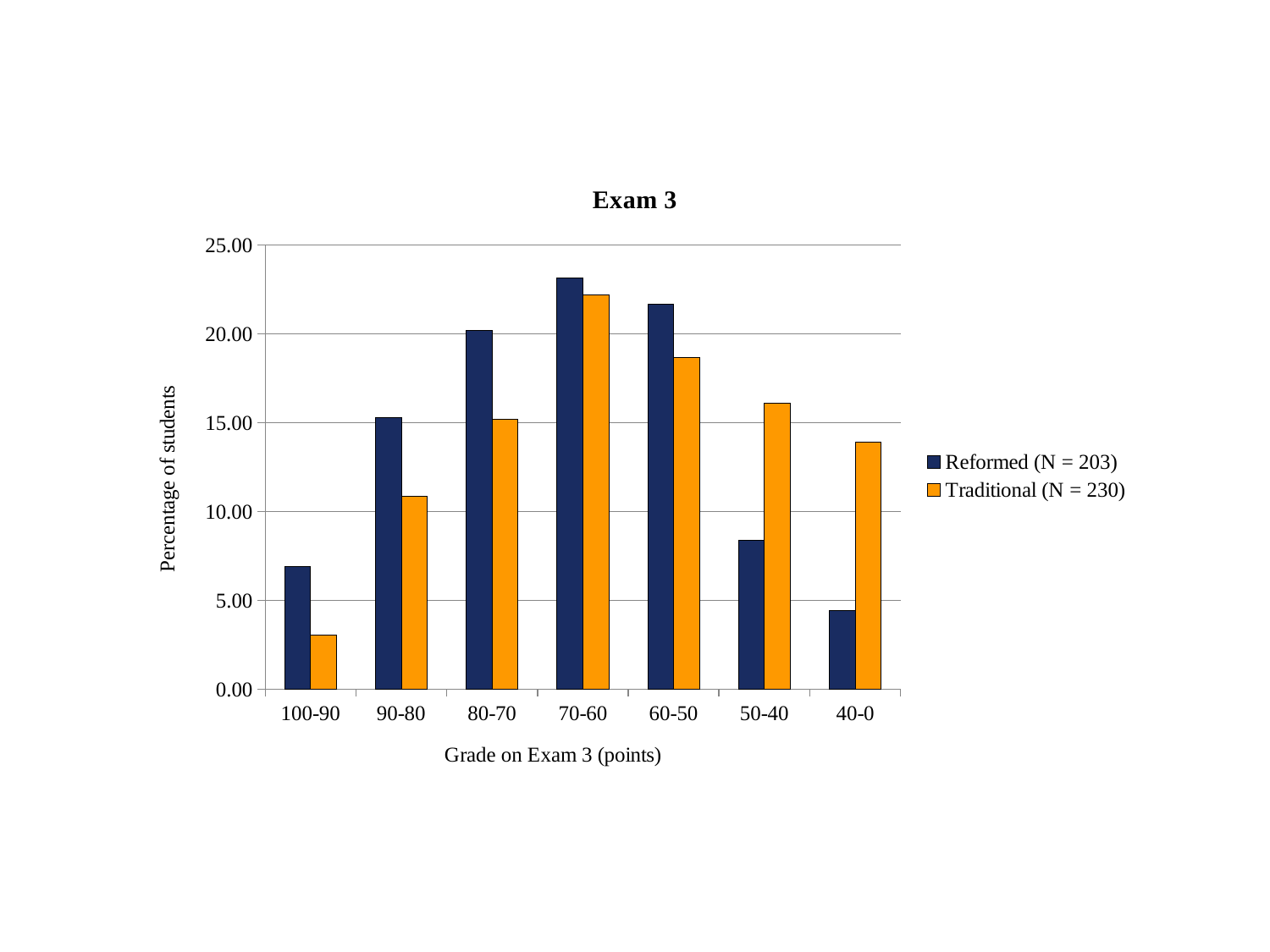
Is the value for Reformed (N = 203) in the 70-60 category greater or less than 20.00? greater Which grade category has the highest value for Reformed (N = 203)? 70-60 How many series does the legend list? 2 Is the value for Reformed (N = 203) in the 50-40 category greater or less than 10.00? less How many grade categories are shown on the x axis? 7 In the 90-80 category, which series has the larger value, Reformed (N = 203) or Traditional (N = 230)? Reformed (N = 203) Which grade category has the lowest value for Reformed (N = 203)? 40-0 Which grade category has the lowest value for Traditional (N = 230)? 100-90 What is the title of the chart? Exam 3 Is the value for Traditional (N = 230) in the 100-90 category greater or less than 5.00? less What type of chart is shown on the slide? Bar chart In the 40-0 category, which series has the larger value, Reformed (N = 203) or Traditional (N = 230)? Traditional (N = 230)